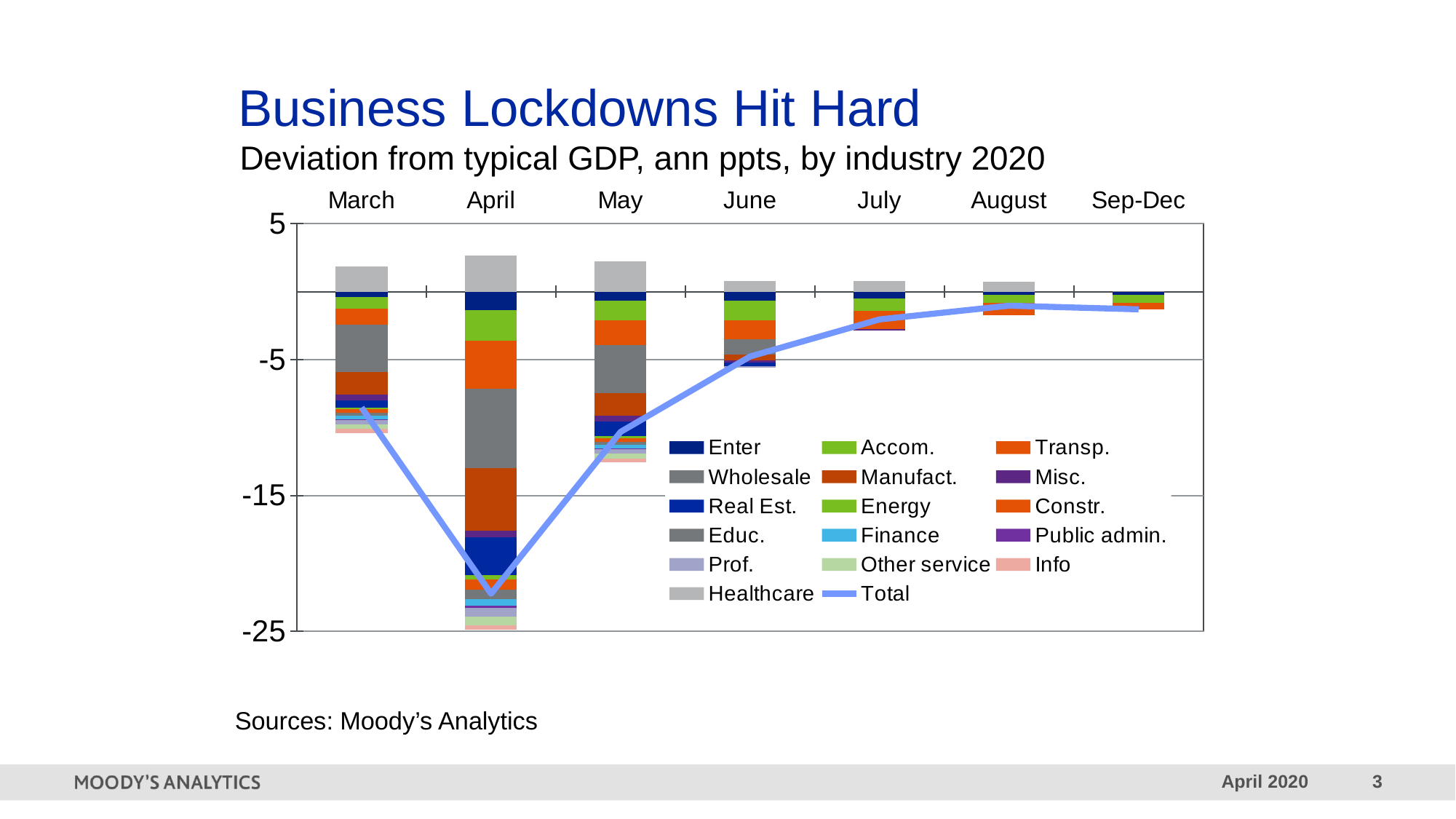
Which series is plotted as a line rather than as stacked bar segments? Total Is the Total value for July greater or less than -5? greater How many time periods are shown along the x axis? 7 What kind of chart is shown on the slide? Stacked bar chart with a line Which month has the largest positive (above zero) portion of its stacked bar? April In which month does the Total line reach its lowest point? April Which has a lower Total value, March or April? April Is the Total value for March greater or less than -15? greater Does the Total line rise or fall from April to Sep-Dec? Rise How many series does the legend list? 17 What is the subtitle describing the chart's measure? Deviation from typical GDP, ann ppts, by industry 2020 Is the Total value for April greater or less than -15? less